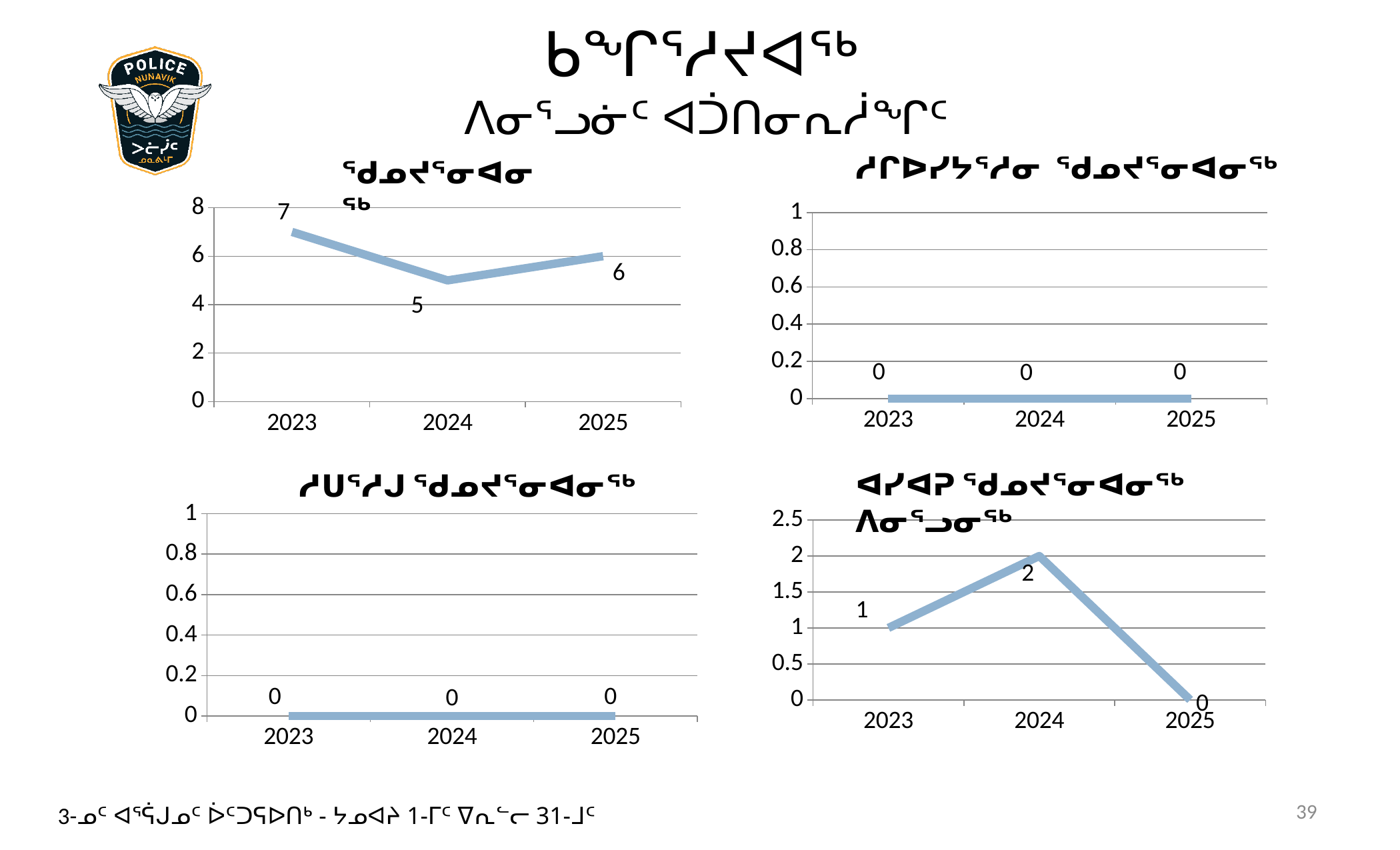
In the top-right chart, what is the value for 2025? 0 In the top-left chart, what is the difference between the values for 2023 and 2025? 1 In the top-left chart, what is the value for 2023? 7 In the bottom-right chart, which is larger, the value for 2023 or the value for 2024? 2024 In the top-left chart, what is the value for 2024? 5 In the top-left chart, is the value for 2025 greater or less than 4? greater In the bottom-right chart, what is the value for 2024? 2 In the top-left chart, which year has the highest value? 2023 What kind of chart is the top-left chart? line chart In the top-left chart, which year has the lowest value? 2024 In the bottom-right chart, what is the value for 2025? 0 How many years are plotted on the x axis of the bottom-left chart? 3